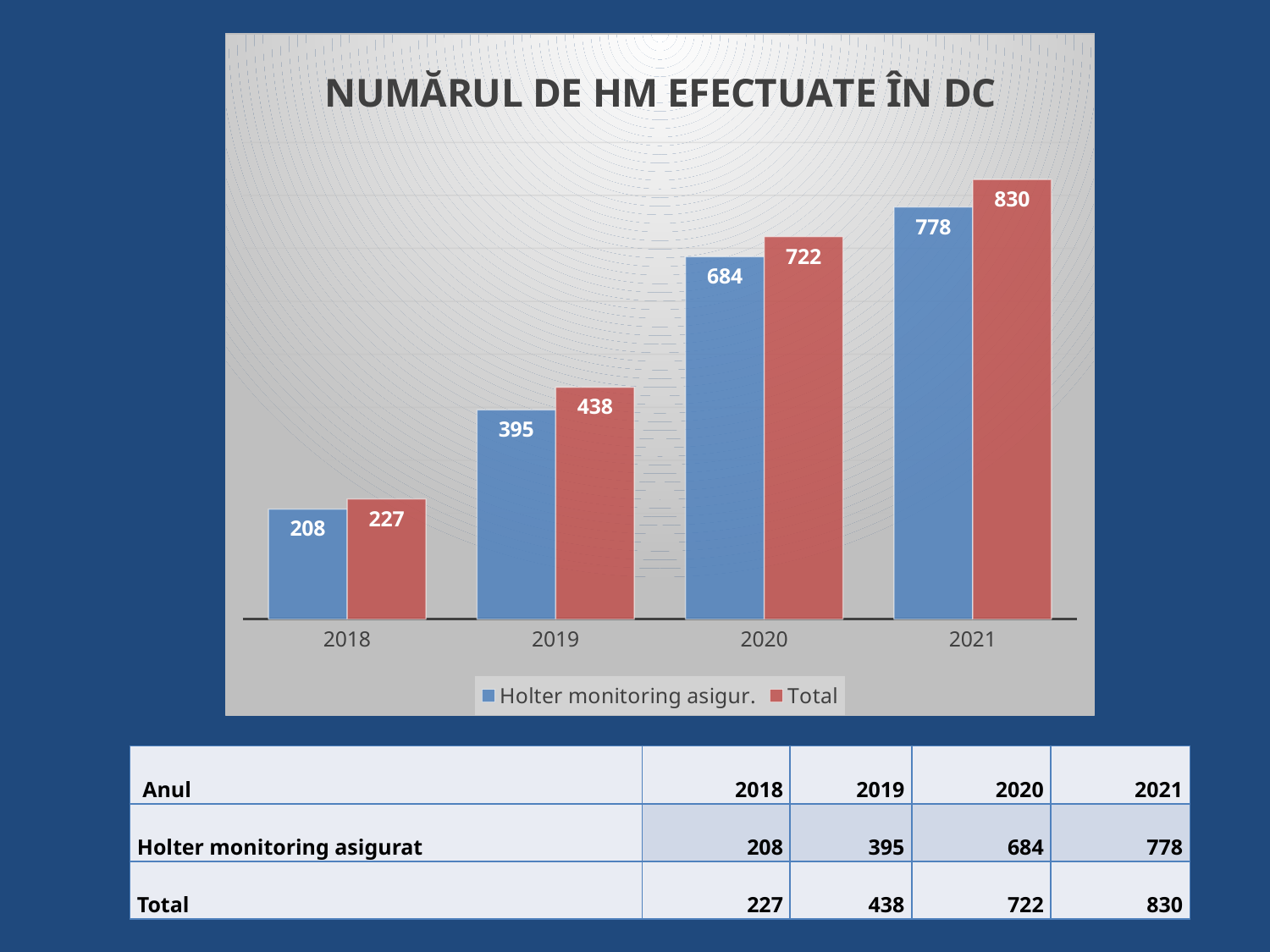
How many series does the legend list? 2 What is the Total value for 2020? 722 Which year has the lowest Holter monitoring asigur. value? 2018 How many years are shown on the x axis of the chart? 4 What kind of chart is shown on the slide? bar chart What is the difference between the Holter monitoring asigur. values for 2020 and 2019? 289 What is the difference between the Total and Holter monitoring asigur. values for 2021? 52 What is the Total value for 2018? 227 What is the value of Holter monitoring asigur. for 2019? 395 Which is larger, the Total value for 2019 or the Holter monitoring asigur. value for 2020? Holter monitoring asigur. value for 2020 Which year has the highest Total value? 2021 Do the Total values rise or fall from 2018 to 2021? rise